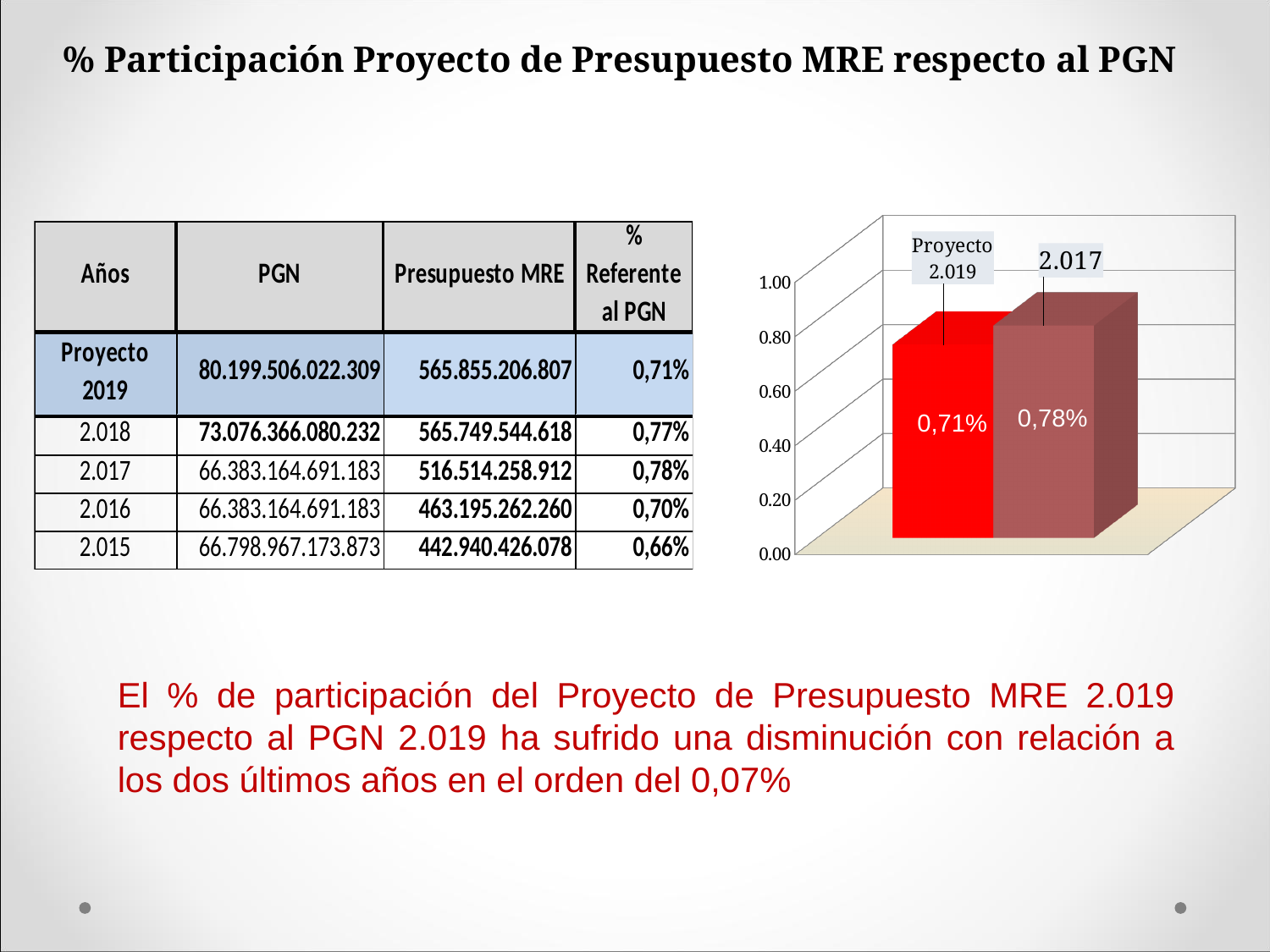
Which bar in the chart is the highest? 2.017 What is the highest tick value shown on the vertical axis of the chart? 1.00 What is the value shown for the 2.017 bar in the chart? 0,78% Is the value for 2.017 in the chart greater or less than 1.00? less What colour is the Proyecto 2.019 bar in the chart? Red What is the difference between the 2.017 value and the Proyecto 2.019 value in the chart? 0,07% Is the value for Proyecto 2.019 in the chart greater or less than 0.60? greater Which bar in the chart is the lowest? Proyecto 2.019 What is the value shown for the Proyecto 2.019 bar in the chart? 0,71% What kind of chart is shown on the slide? Bar chart How many bars are plotted in the chart? 2 Which is larger in the chart, the value for Proyecto 2.019 or the value for 2.017? 2.017